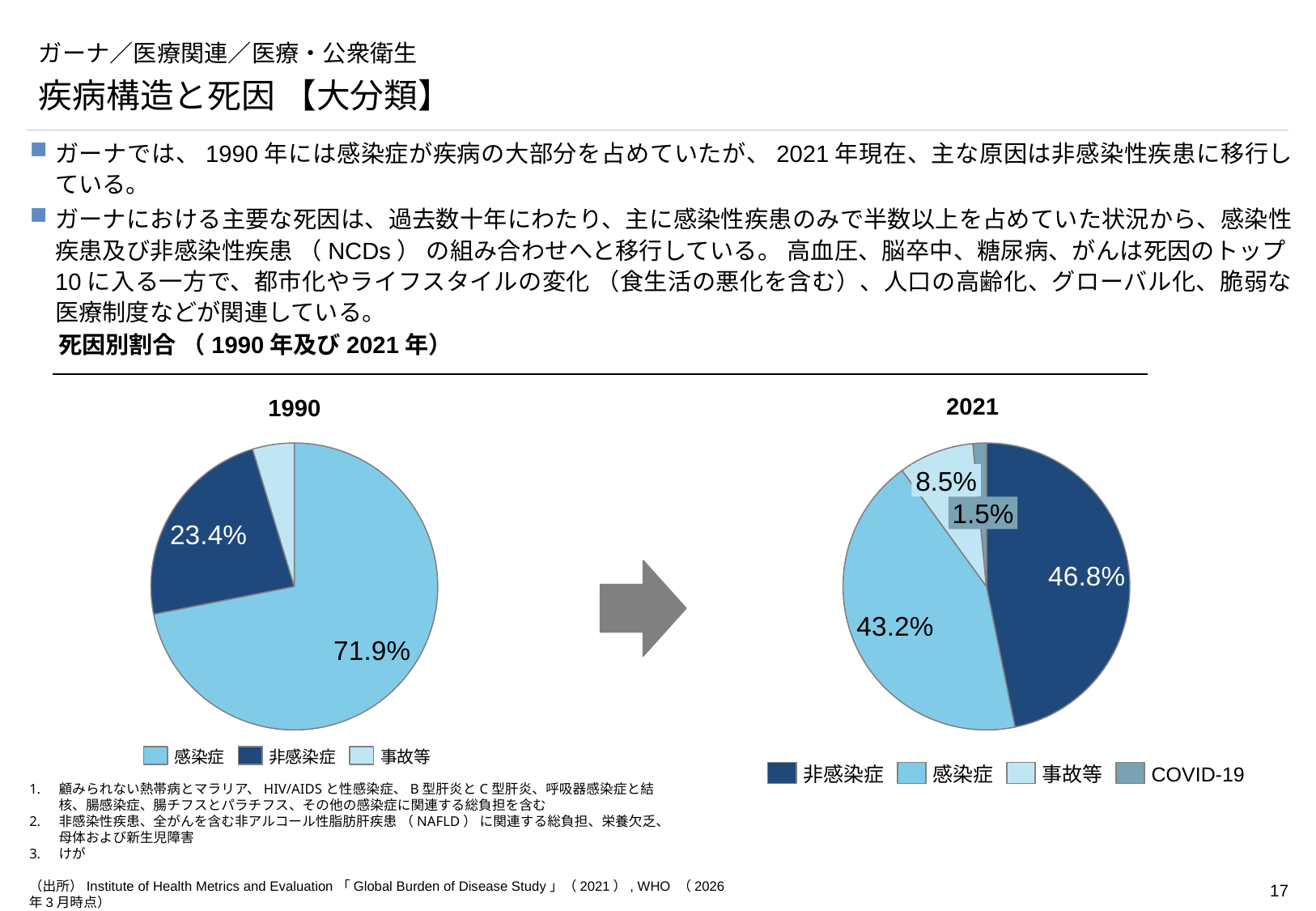
In the 2021 pie chart, which category has the smallest slice? COVID-19 In the 1990 pie chart, what is the difference between the 感染症 share and the 非感染症 share? 48.5% In the 1990 pie chart, which category has the largest slice? 感染症 What kind of chart is used for the 1990 data? Pie chart In the 2021 pie chart, what share is labelled for COVID-19? 1.5% How many categories does the legend of the 2021 pie chart list? 4 In the 2021 pie chart, what share is labelled for 非感染症? 46.8% In the 2021 pie chart, what is the difference between the 非感染症 share and the 感染症 share? 3.6% In the 2021 pie chart, what share is labelled for 事故等? 8.5% In the 2021 pie chart, which is larger, the share for 事故等 or the share for COVID-19? 事故等 In the 1990 pie chart, what share is labelled for 感染症? 71.9% In the 1990 pie chart, what share is labelled for 非感染症? 23.4%